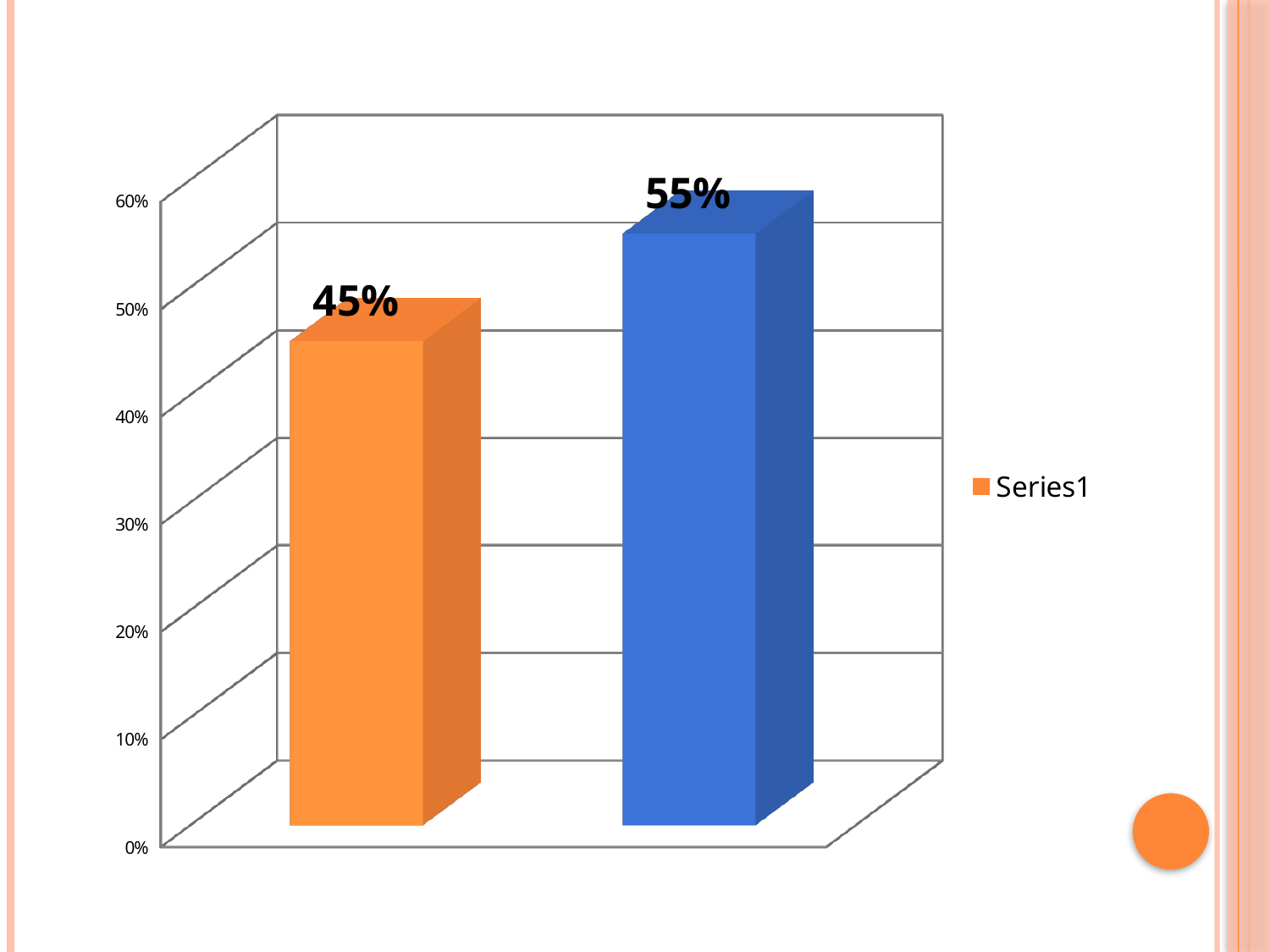
Is the value for the blue bar greater or less than 50%? greater How many series does the legend list? 1 What is the value shown on the orange bar? 45% What is the value shown on the blue bar? 55% Is the value for the orange bar greater or less than 50%? less How many bars are plotted in the chart? 2 Which bar has the lowest value, the orange bar or the blue bar? the orange bar Is the value of the orange bar larger or smaller than the value of the blue bar? smaller Which bar has the highest value, the orange bar or the blue bar? the blue bar What is the difference between the value of the blue bar and the value of the orange bar? 10% What is the name of the series listed in the legend? Series1 What kind of chart is shown on the slide? bar chart